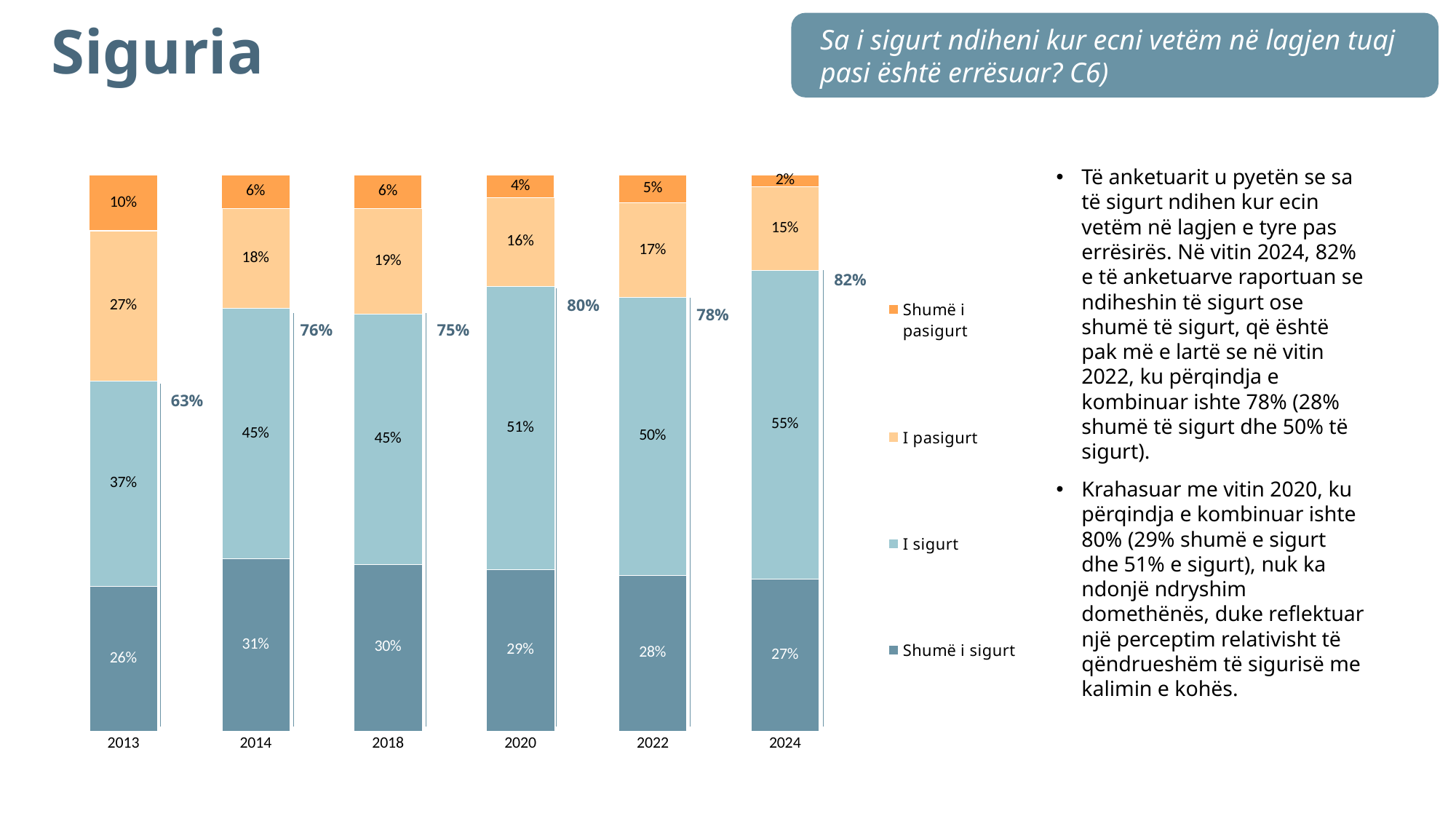
What is the value for 'I sigurt' in 2024? 55% What is the value for 'Shumë i sigurt' in 2014? 31% Which is larger, the 'I pasigurt' value in 2013 or in 2022? 2013 What is the value for 'Shumë i pasigurt' in 2013? 10% What combined percentage is labelled next to the 2020 bar? 80% How many series does the legend list? 4 How many years are shown on the x axis of the chart? 6 In which year is the 'I sigurt' value highest? 2024 In which year is the 'Shumë i pasigurt' value lowest? 2024 What is the difference between the 'I sigurt' values for 2024 and 2013? 18% What is the value for 'I pasigurt' in 2018? 19% What kind of chart is shown on the slide? Stacked bar chart